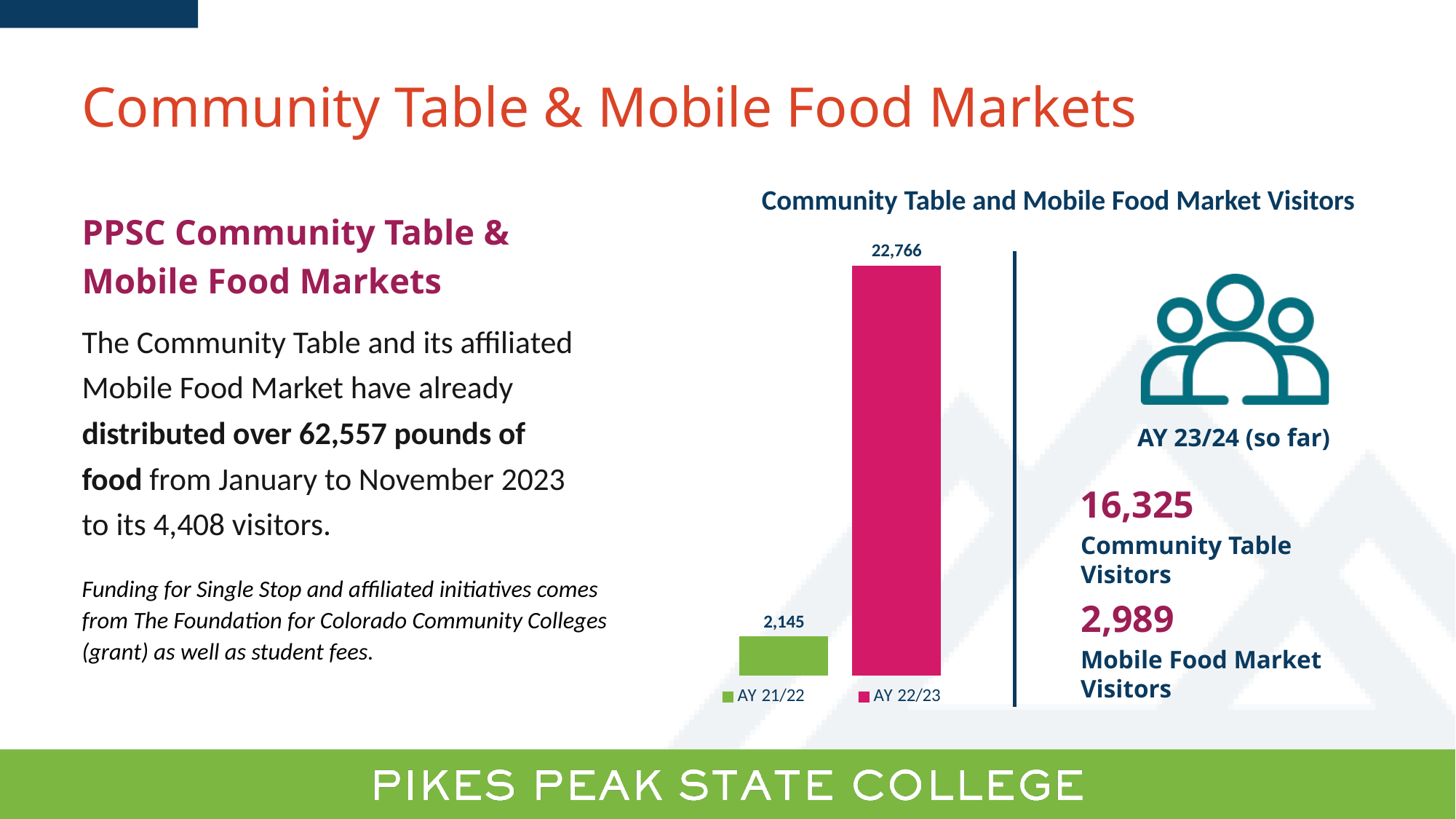
How many entries does the legend of the chart list? 2 What is the value for AY 22/23 in the Community Table and Mobile Food Market Visitors chart? 22,766 What is the title of the chart on the slide? Community Table and Mobile Food Market Visitors Which academic year has the highest number of visitors in the chart? AY 22/23 Which academic year has the lowest number of visitors in the chart? AY 21/22 Which is larger, the visitors for AY 21/22 or AY 22/23? AY 22/23 What is the difference in visitors between AY 22/23 and AY 21/22? 20,621 What colour is the bar for AY 21/22 in the chart? Green How many bars are plotted in the Community Table and Mobile Food Market Visitors chart? 2 What is the value for AY 21/22 in the Community Table and Mobile Food Market Visitors chart? 2,145 What kind of chart is shown on the slide? Bar chart Do the visitor numbers rise or fall from AY 21/22 to AY 22/23? Rise